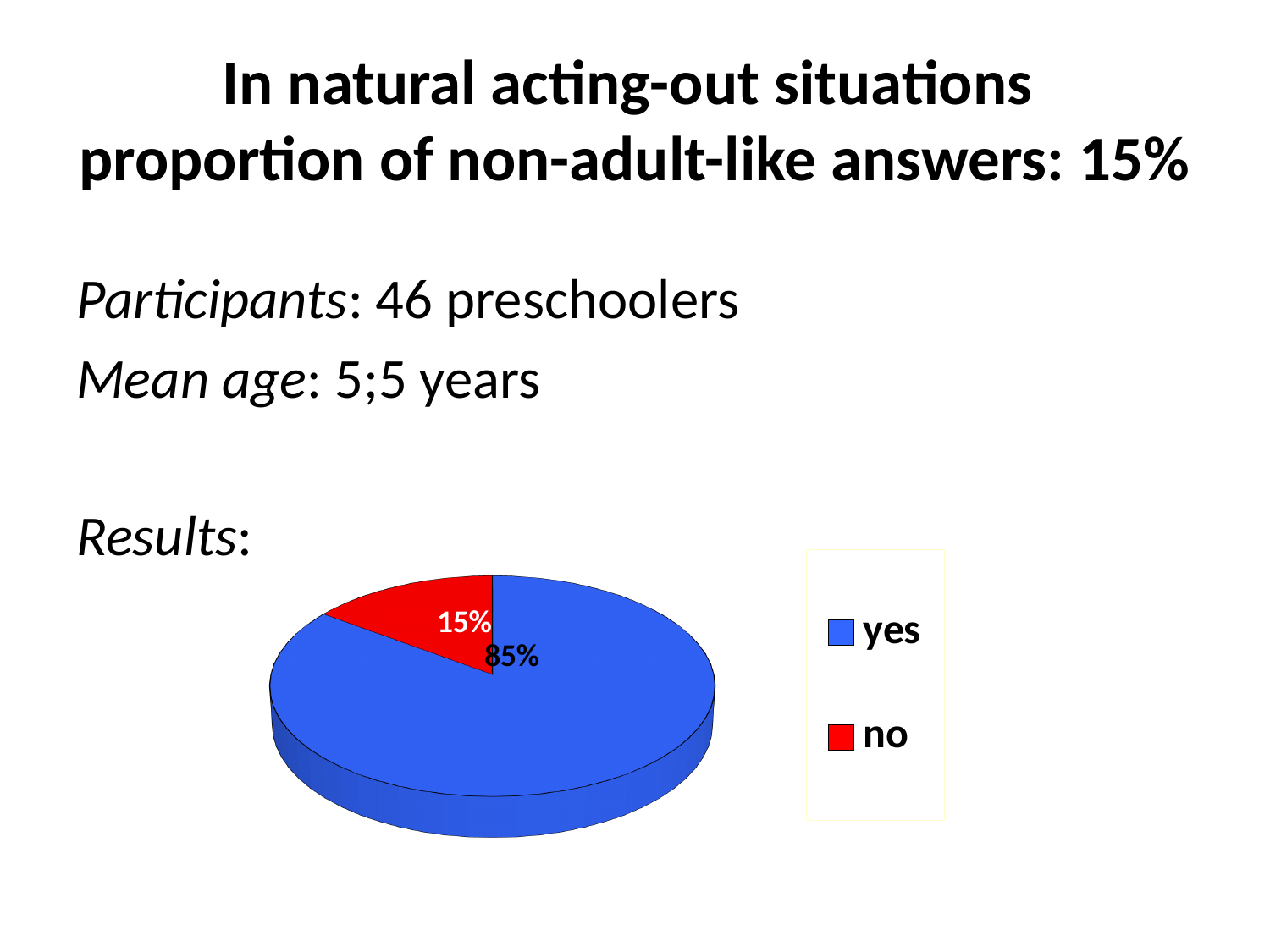
What share of the pie does the "no" slice represent? 15% Which is larger, the "yes" slice or the "no" slice? yes What colour is the "no" slice in the pie chart? red What colour is the "yes" slice in the pie chart? blue What kind of chart is shown on the slide? pie chart Which slice of the pie is the largest? yes What is the difference in percentage points between the "yes" and "no" slices? 70% What share of the pie does the "yes" slice represent? 85% How many entries does the legend list? 2 How many slices does the pie chart have? 2 Which slice of the pie is the smallest? no